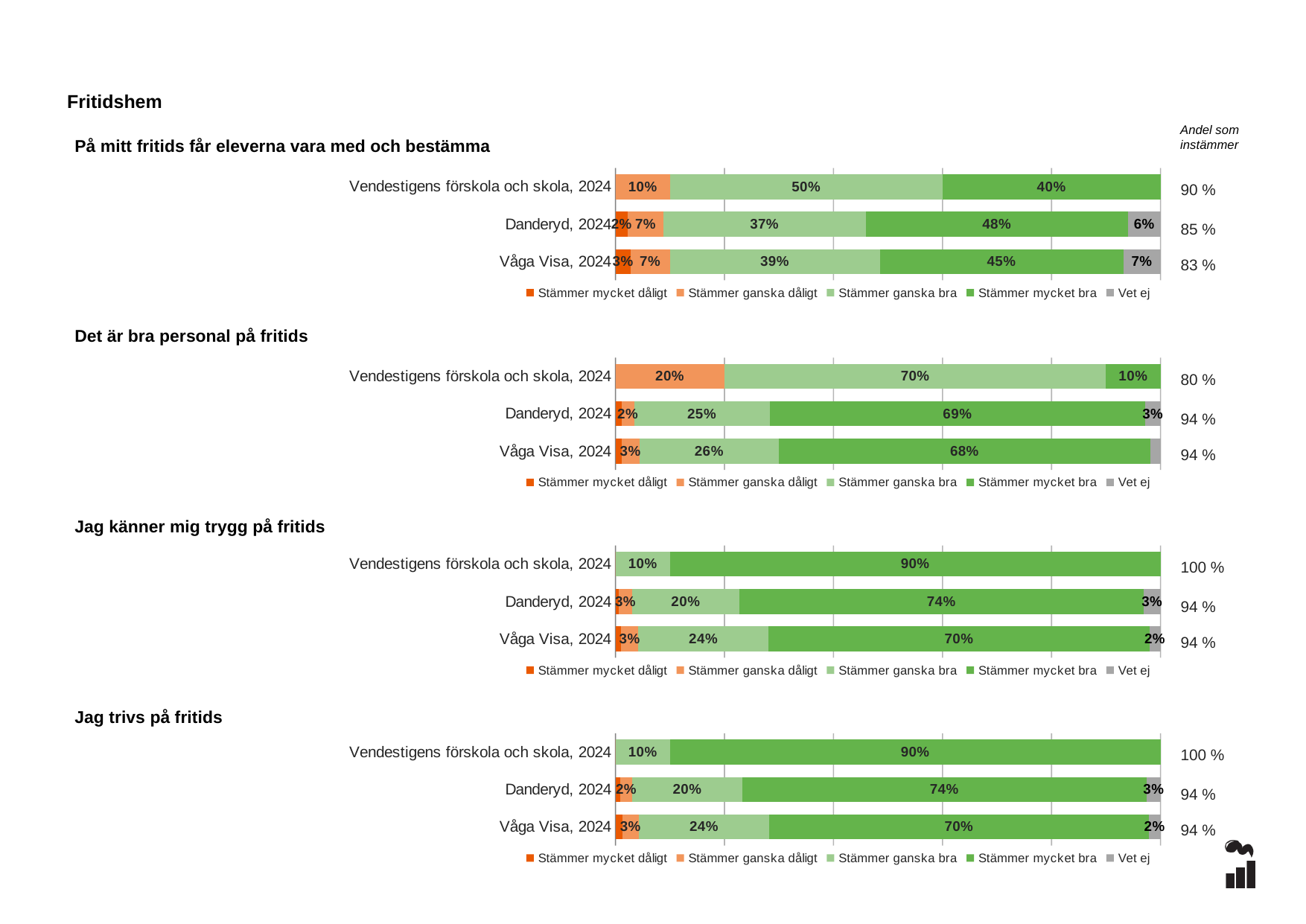
In the chart 'Det är bra personal på fritids', what percentage of Vendestigens förskola och skola, 2024 answered 'Stämmer ganska dåligt'? 20% What kind of chart is 'Jag trivs på fritids'? Stacked bar chart In the chart 'Jag trivs på fritids', what is the 'Andel som instämmer' value for Vendestigens förskola och skola, 2024? 100 % In the chart 'Jag trivs på fritids', which is larger: the 'Stämmer ganska bra' value for Danderyd, 2024 or for Våga Visa, 2024? Våga Visa, 2024 In the chart 'På mitt fritids får eleverna vara med och bestämma', what is the 'Stämmer mycket bra' value for Danderyd, 2024? 48% How many series does the legend list for the chart 'Det är bra personal på fritids'? 5 In the chart 'Jag känner mig trygg på fritids', what is the 'Stämmer mycket bra' value for Vendestigens förskola och skola, 2024? 90% In the chart 'På mitt fritids får eleverna vara med och bestämma', what is the 'Andel som instämmer' value for Våga Visa, 2024? 83 % In the chart 'Det är bra personal på fritids', which row has the highest 'Stämmer mycket bra' value? Danderyd, 2024 In the chart 'Jag känner mig trygg på fritids', what is the difference between the 'Stämmer mycket bra' values for Danderyd, 2024 and Våga Visa, 2024? 4% How many bars are shown in the chart 'Jag känner mig trygg på fritids'? 3 In the chart 'På mitt fritids får eleverna vara med och bestämma', what percentage of Vendestigens förskola och skola, 2024 answered 'Stämmer ganska bra'? 50%